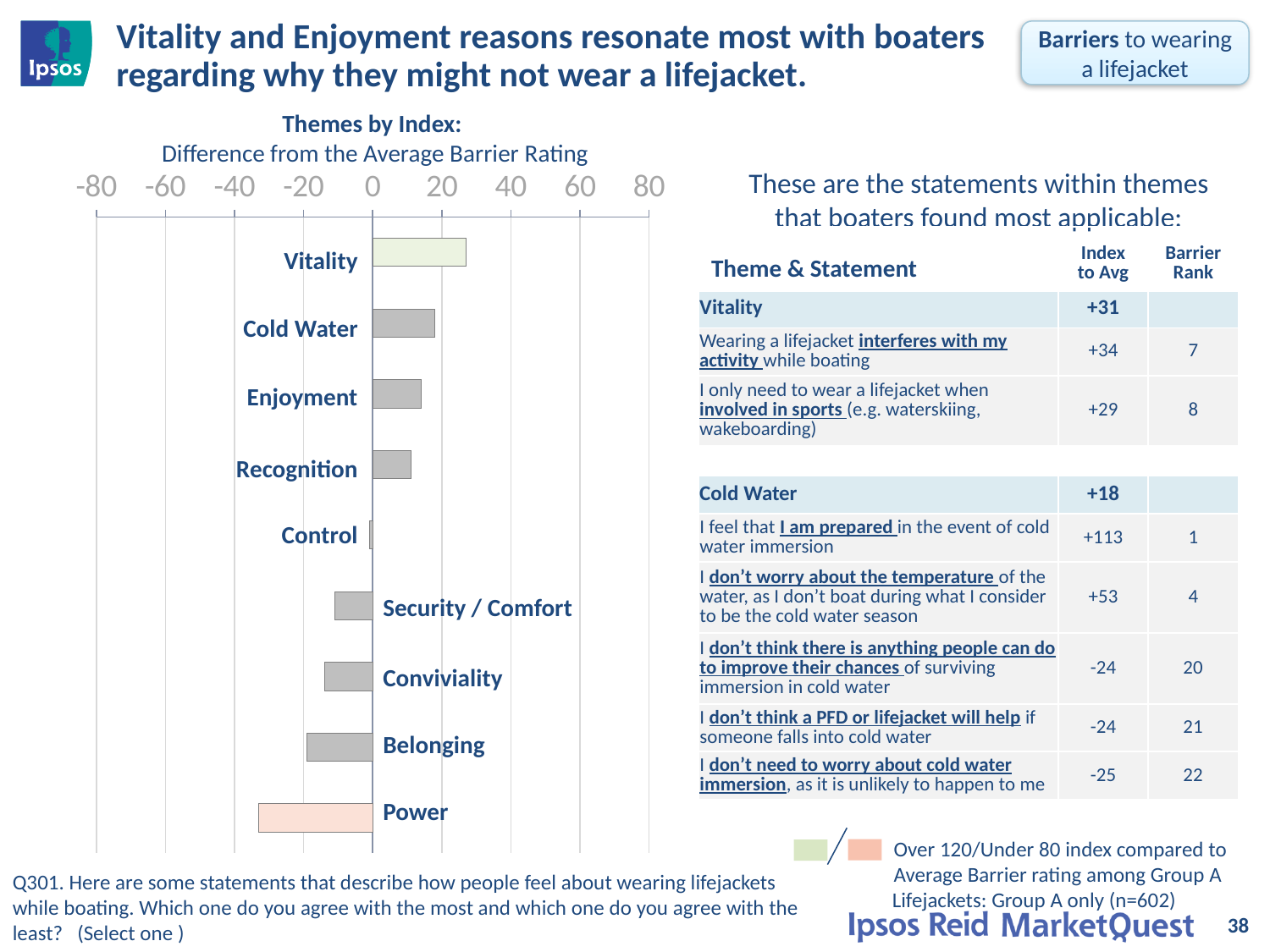
Is the value for Vitality greater or less than 20? greater What kind of chart is shown on the slide? bar chart Which theme has the highest index difference in the bar chart? Vitality How many themes are plotted in the bar chart? 9 Which has the larger index difference, Vitality or Cold Water? Vitality Which has the larger index difference, Recognition or Enjoyment? Enjoyment Is the value for Security / Comfort greater or less than -20? greater What is the title of the bar chart? Themes by Index: Difference from the Average Barrier Rating Which theme has the lowest index difference in the bar chart? Power Is the value for Power greater or less than -20? less Do the bar values rise or fall going from the top theme (Vitality) to the bottom theme (Power)? fall